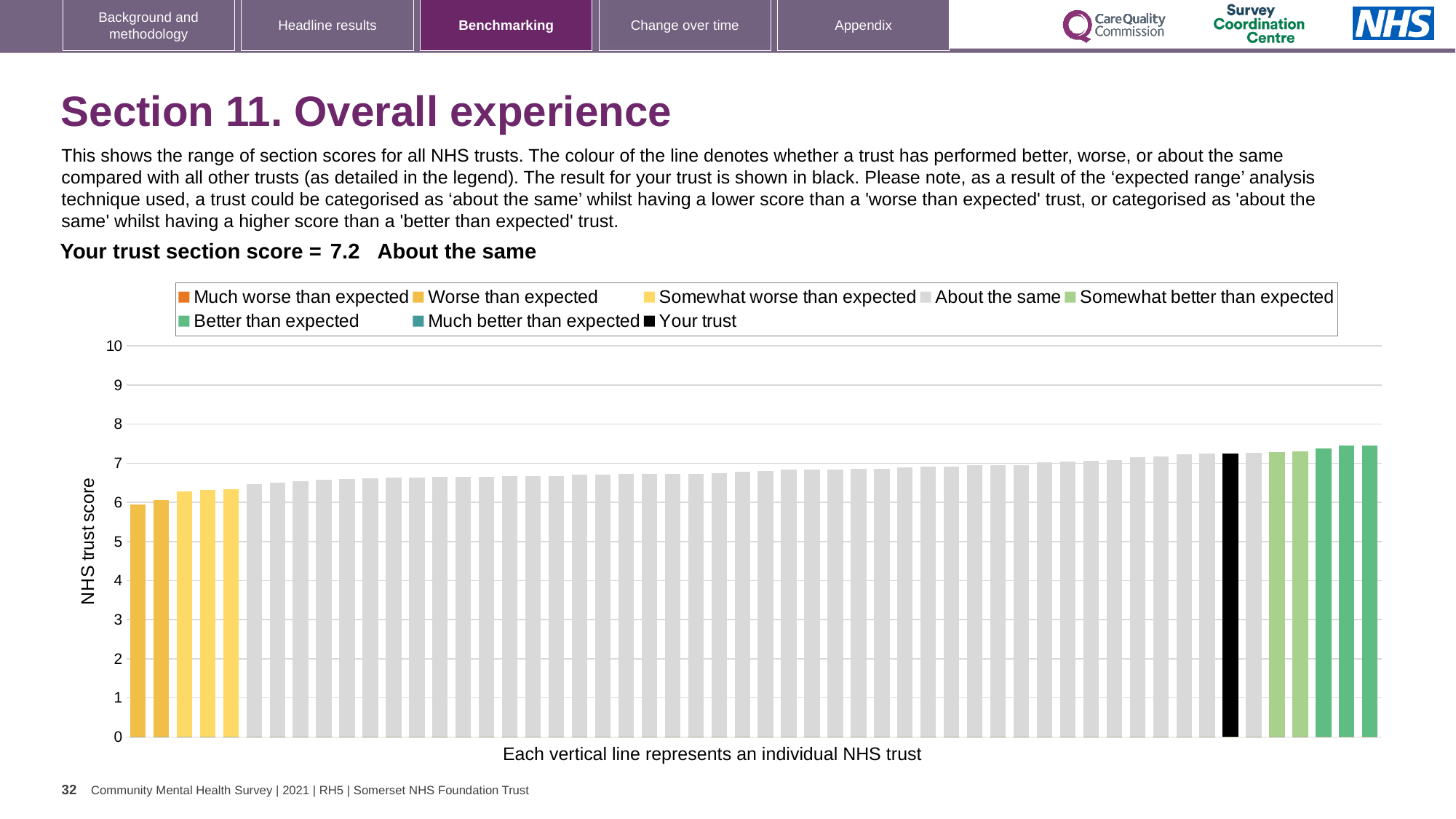
Which bar is the highest on the chart: the leftmost or the rightmost? rightmost Do the bar values rise or fall from left to right along the x axis? rise How many entries does the chart legend list? 8 Is the value of the lowest bar greater or less than 5? greater What is the section score for your trust shown on the slide? 7.2 What colour is used for the bar representing your trust? Black What kind of chart is shown on the slide? Bar chart Is the value of the highest bar greater or less than 8? less Is the leftmost bar higher or lower than the black bar for your trust? lower What is the label on the vertical axis of the chart? NHS trust score Is the value for your trust (the black bar) greater or less than 7? greater Which category is your trust placed in according to the slide? About the same